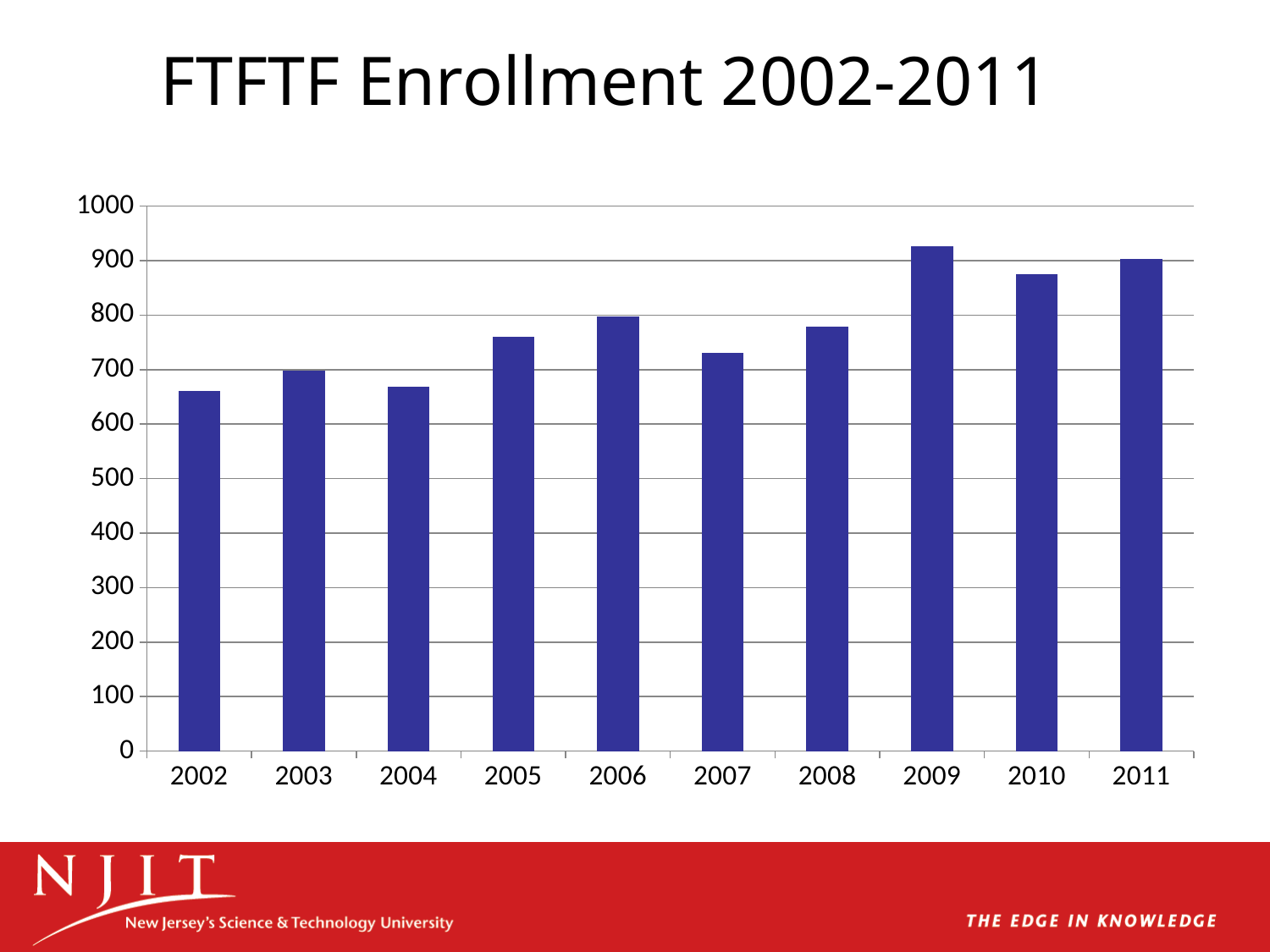
Which year has the highest FTFTF enrollment? 2009 Is the value for 2010 greater or less than 800? greater Which year has the larger enrollment, 2006 or 2007? 2006 Overall, does FTFTF enrollment rise or fall from 2002 to 2011? rise Is the value for 2008 greater or less than 800? less Is the value for 2002 greater or less than 700? less What kind of chart is shown on the slide? bar chart How many years are shown on the x axis of the chart? 10 What is the title of the chart? FTFTF Enrollment 2002-2011 Which year has the larger enrollment, 2009 or 2010? 2009